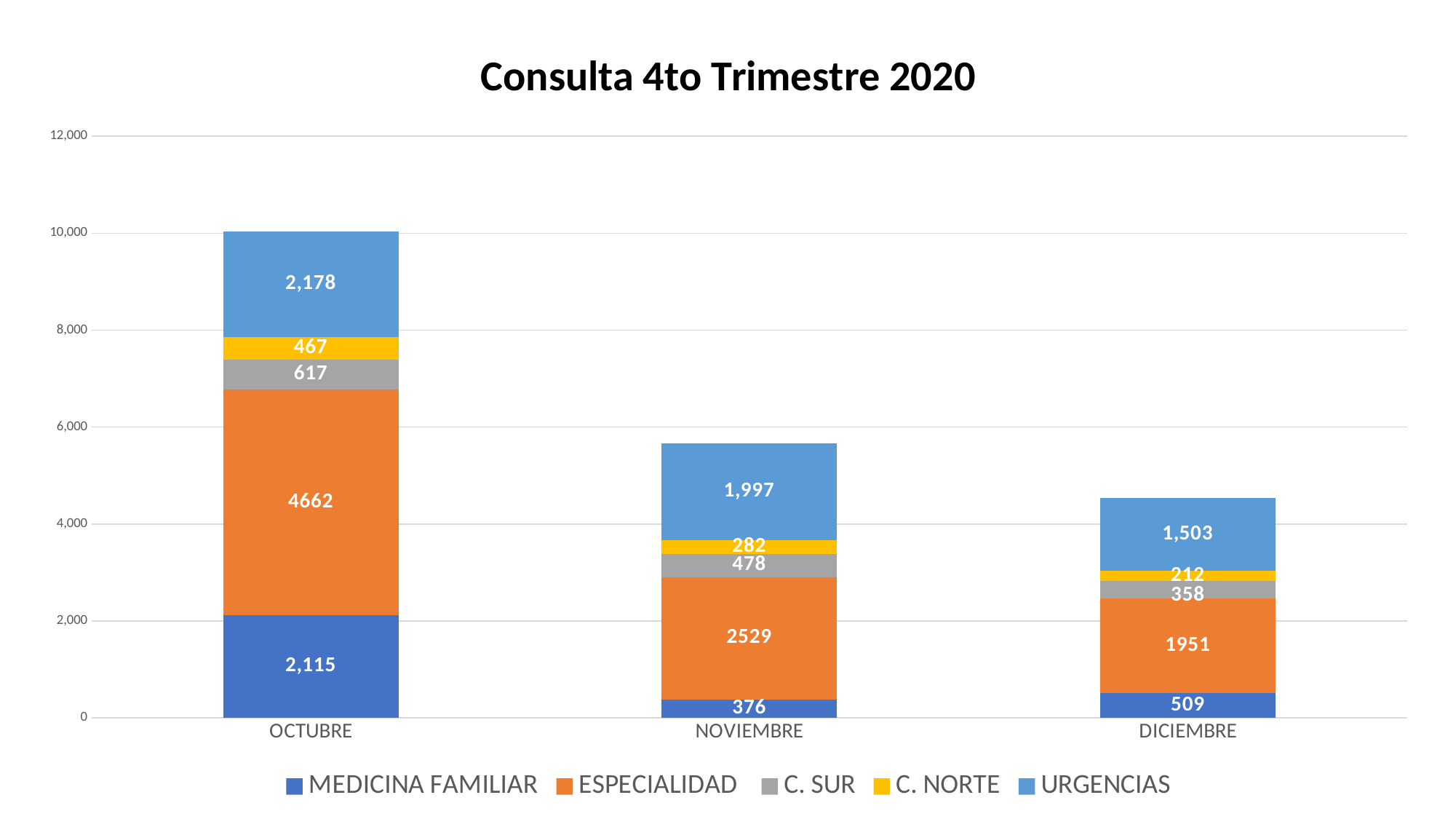
What is the value for URGENCIAS in NOVIEMBRE? 1,997 What is the total of the stacked bar for DICIEMBRE? 4533 What kind of chart is shown on the slide? Stacked bar chart What is the difference between the ESPECIALIDAD values for OCTUBRE and NOVIEMBRE? 2133 How many months are shown on the x axis? 3 Which is larger: C. SUR in OCTUBRE or C. SUR in DICIEMBRE? C. SUR in OCTUBRE Which month has the lowest value for MEDICINA FAMILIAR? NOVIEMBRE Which month has the highest value for ESPECIALIDAD? OCTUBRE How many series does the legend list? 5 What is the value for C. NORTE in DICIEMBRE? 212 What is the value for MEDICINA FAMILIAR in NOVIEMBRE? 376 What is the value for ESPECIALIDAD in OCTUBRE? 4662